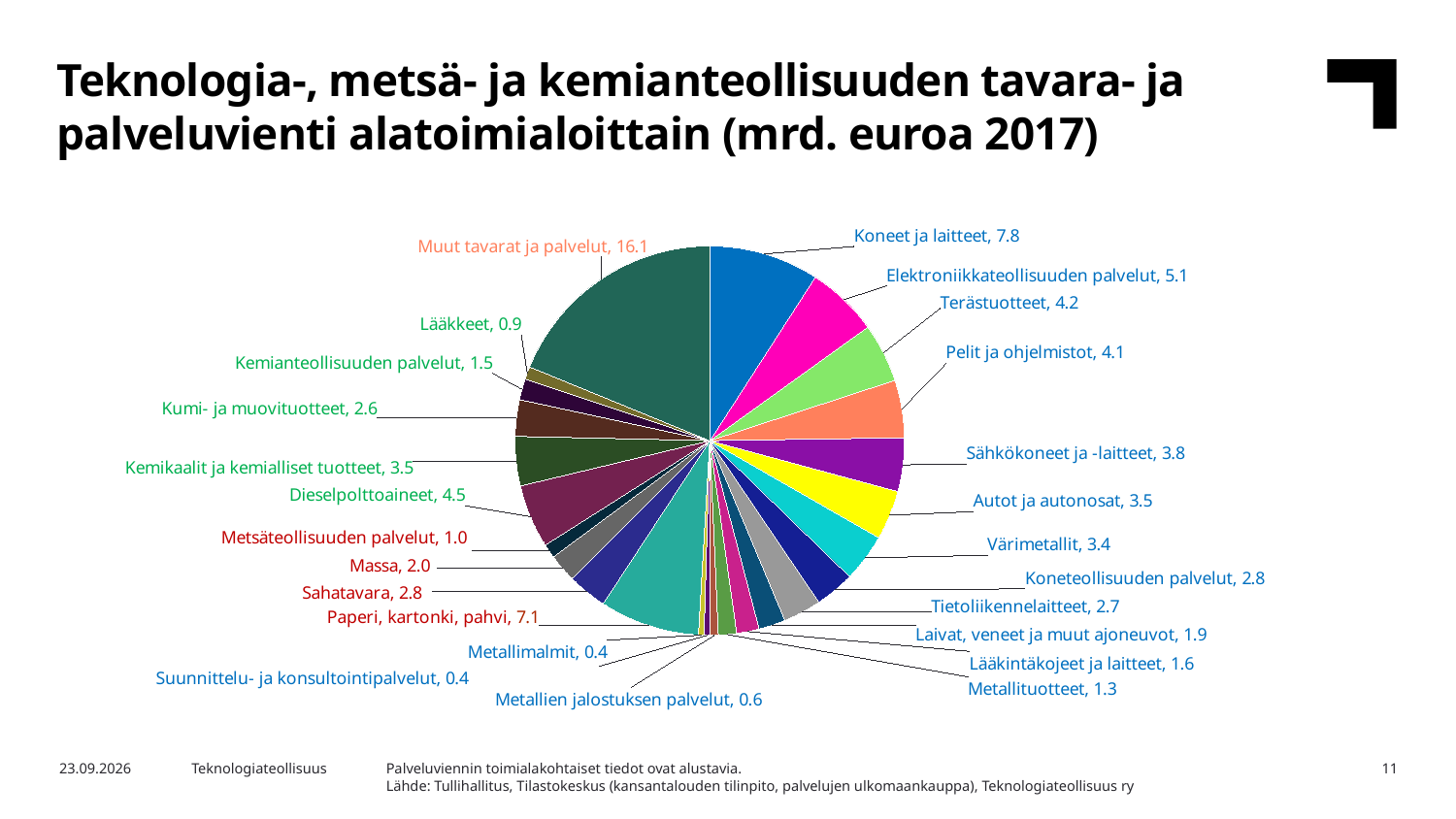
What is the value for Kemianteollisuuden palvelut? 1.5 What is the value for Lääkintäkojeet ja laitteet? 1.6 How many slices does the pie chart have? 25 Which is larger, Pelit ja ohjelmistot or Sähkökoneet ja -laitteet? Pelit ja ohjelmistot What type of chart is shown on the slide? Pie chart What is the value for Koneet ja laitteet? 7.8 What is the difference between Muut tavarat ja palvelut and Koneet ja laitteet? 8.3 What is the difference between Koneet ja laitteet and Paperi, kartonki, pahvi? 0.7 What is the value for Paperi, kartonki, pahvi? 7.1 What unit and year does the slide title give for the values? mrd. euroa 2017 Which category has the largest slice of the pie? Muut tavarat ja palvelut What is the value for Dieselpolttoaineet? 4.5